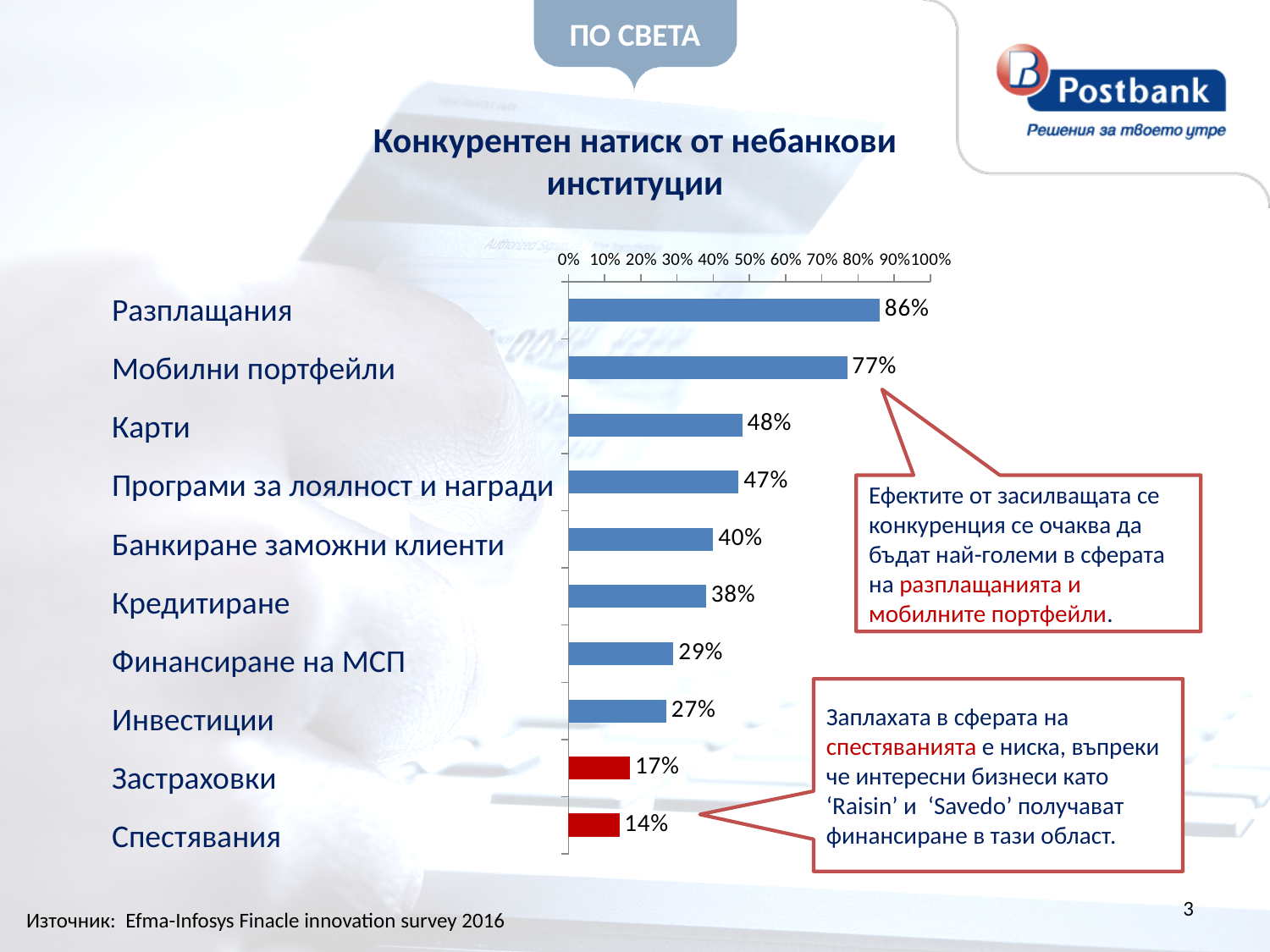
What is the difference between the values for Застраховки and Спестявания? 3% What is the value for Спестявания? 14% Which is larger, the value for Карти or the value for Банкиране заможни клиенти? Карти Which category has the highest value? Разплащания How many categories are shown in the chart? 10 Is the value for Финансиране на МСП greater or less than 30%? less What is the value for Кредитиране? 38% Which category has the lowest value? Спестявания What is the value for Мобилни портфейли? 77% What is the difference between the values for Разплащания and Мобилни портфейли? 9% What kind of chart is shown on the slide? bar chart What is the value for Разплащания? 86%